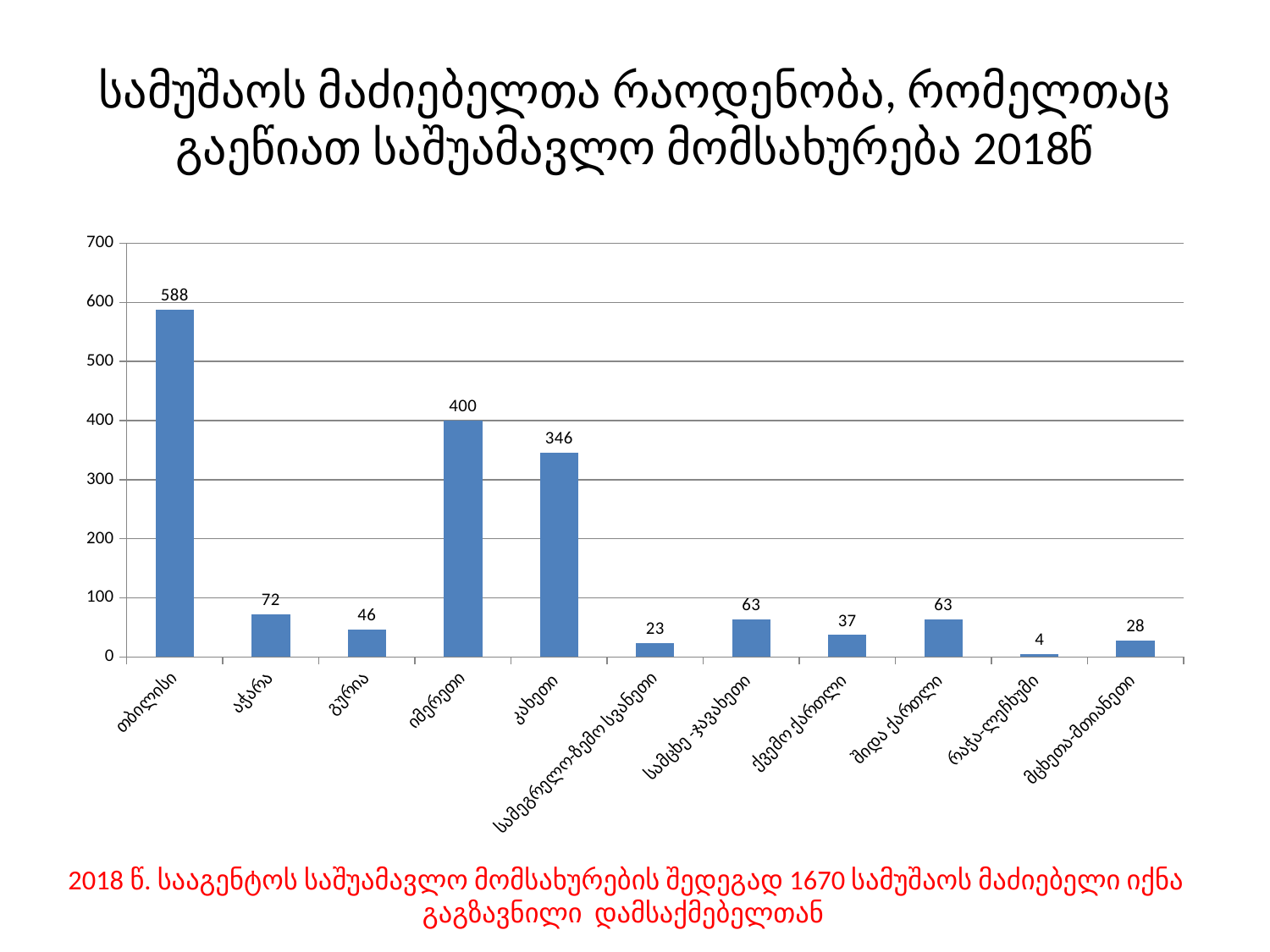
Which category has the highest value? თბილისი Which category has the lowest value? რაჭა-ლეჩხუმი How many categories are shown on the x axis? 11 What is the value for თბილისი? 588 What is the difference between the values for თბილისი and იმერეთი? 188 What is the value for კახეთი? 346 Is the value for კახეთი greater or less than 300? greater What kind of chart is shown on the slide? bar chart What is the value for იმერეთი? 400 What is the value for ქვემო ქართლი? 37 What is the value for რაჭა-ლეჩხუმი? 4 Which is larger, the value for აჭარა or the value for გურია? აჭარა